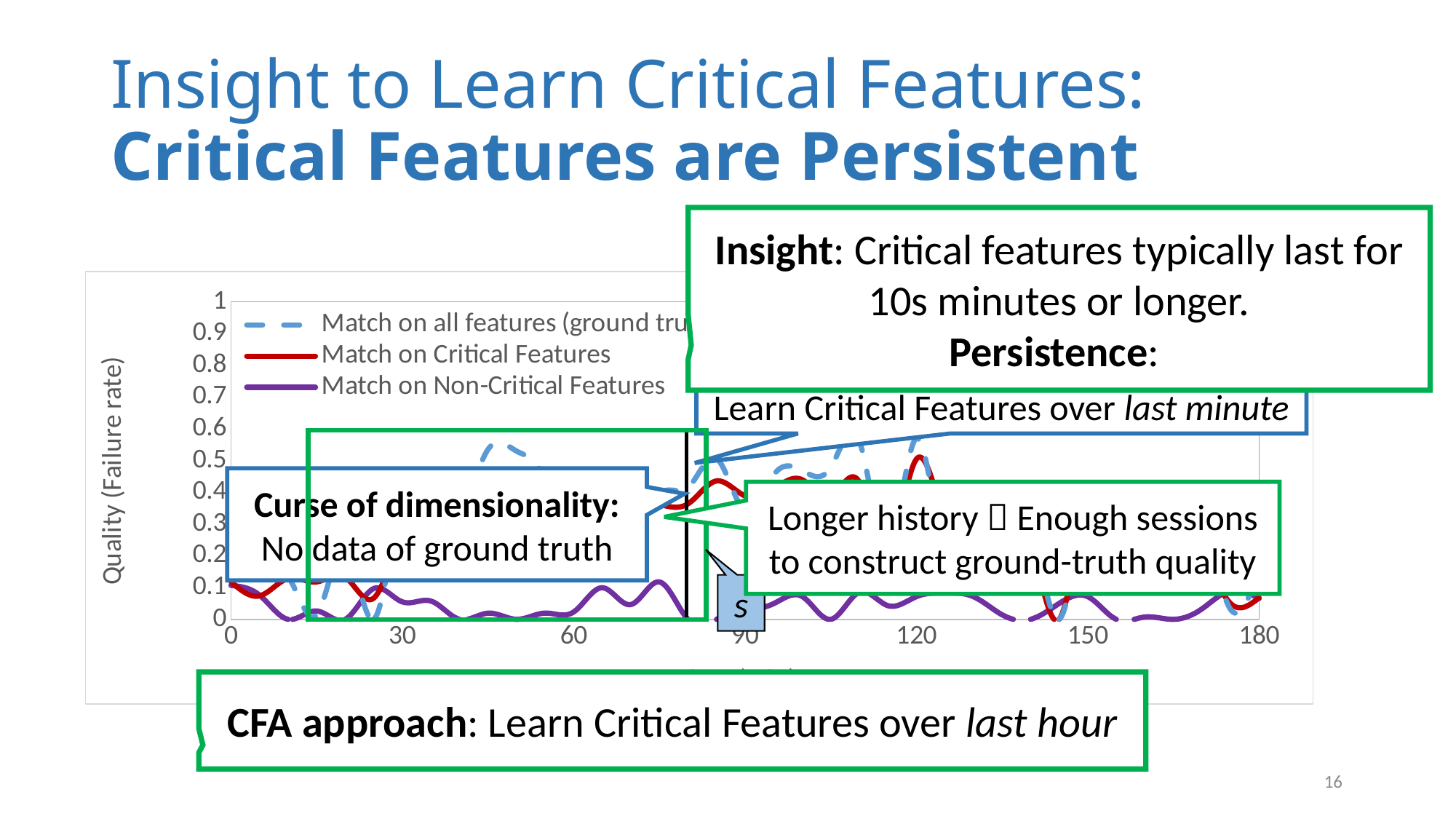
What is the maximum value shown on the y-axis of the chart? 1 Is the value of the Match on Non-Critical Features series at x = 120 greater or less than 0.3? less Is the value of the Match on Non-Critical Features series at x = 60 greater or less than 0.5? less Which series stays lowest across the chart, Match on Critical Features or Match on Non-Critical Features? Match on Non-Critical Features How many series does the chart's legend list? 3 What is the spacing between consecutive tick labels on the x-axis of the chart? 30 What is the label of the y-axis of the chart? Quality (Failure rate) What is the spacing between consecutive tick labels on the y-axis of the chart? 0.1 How many tick labels are shown on the x-axis of the chart? 7 What kind of chart is shown on the slide? line chart What is the largest value shown on the x-axis of the chart? 180 Which series in the legend is drawn with a dashed line? Match on all features (ground truth)